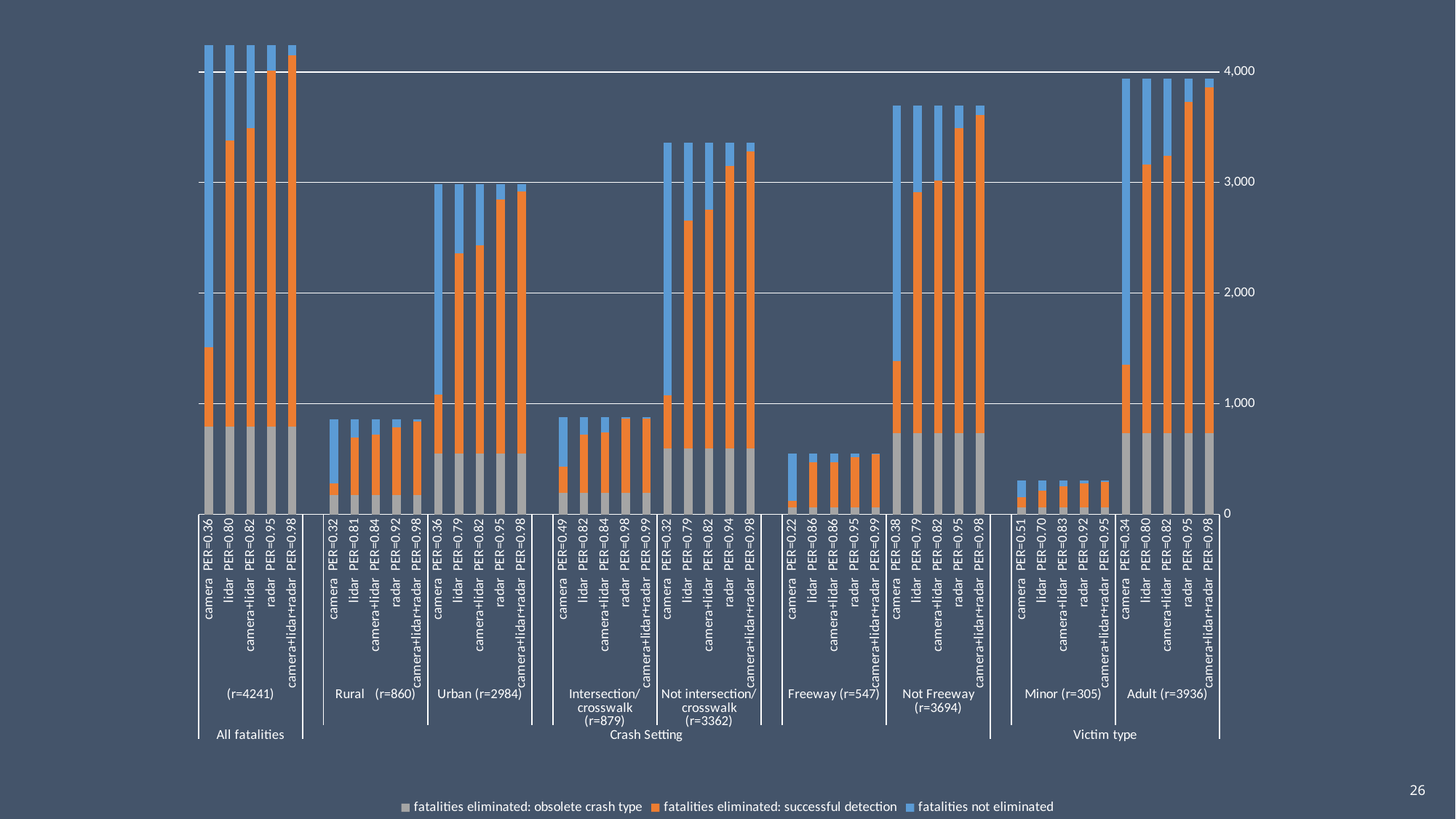
Which colour represents 'fatalities not eliminated' in the legend? Blue Which group has taller total bars, Freeway (r=547) or Not Freeway (r=3694)? Not Freeway (r=3694) Is the total height of the camera bar in the Rural (r=860) group greater or less than 1,000? less Is the total height of the camera bar in the Minor (r=305) group greater or less than 1,000? less How many series does the legend list? 3 Which group has the tallest total bars on the chart? All fatalities How many sensor configurations (bars) are shown within each group, such as the Rural (r=860) group? 5 How many labelled groups (such as Rural, Urban, Freeway) are shown along the x axis? 9 Is the total height of the camera bar in the All fatalities group greater or less than 4,000? greater What kind of chart is shown on the slide? Stacked bar chart In the All fatalities group, does the 'fatalities not eliminated' portion rise or fall from the camera bar to the camera+lidar+radar bar? fall